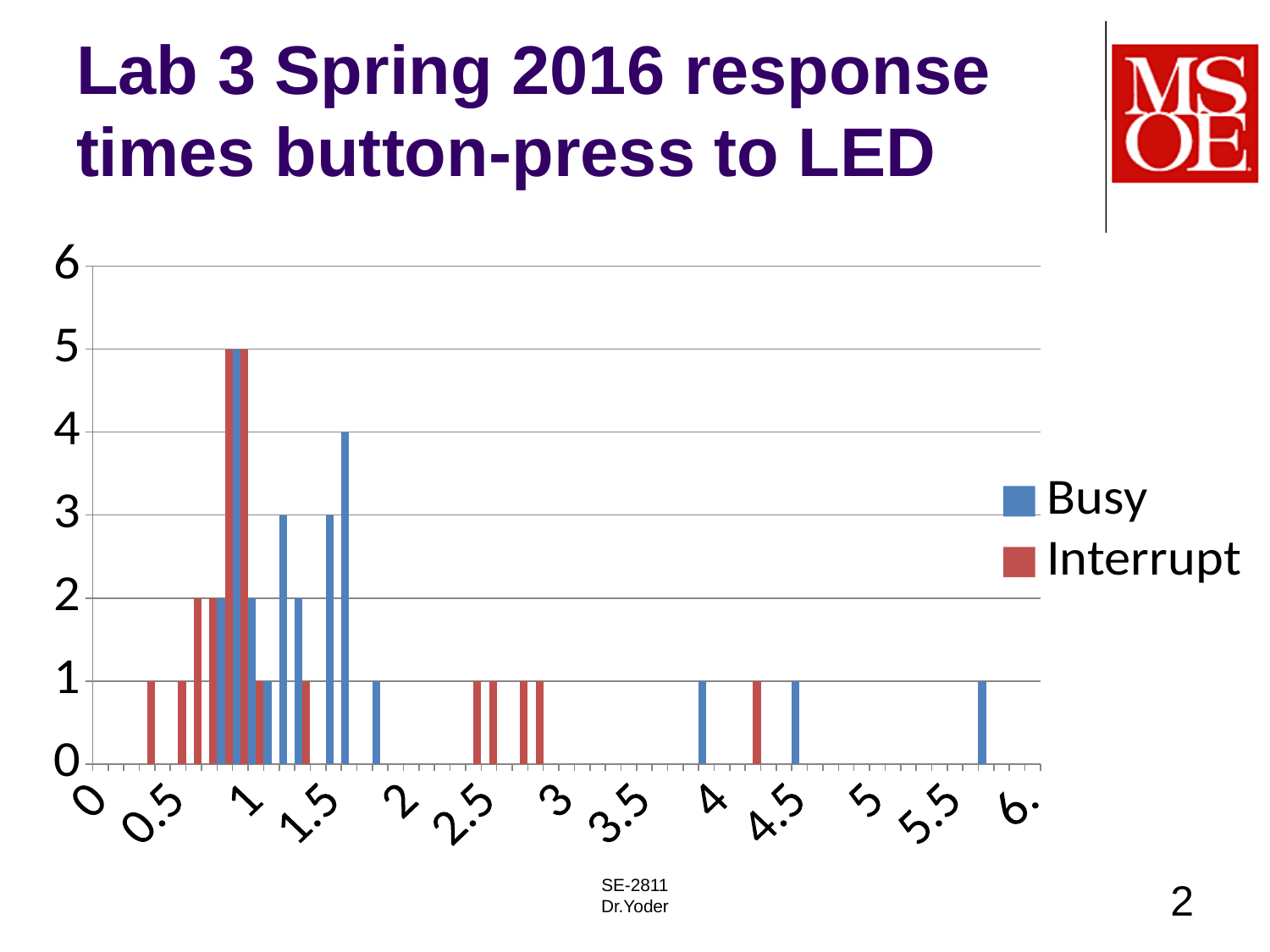
Is the Busy bar located just before 4 on the x axis greater or less than 2? less How many labelled tick values are shown on the x axis? 13 Are there any bars between 3 and 4 on the x axis? Yes How many series does the legend list? 2 Is the tallest bar in the chart greater or less than 4? greater Which series has a bar located beyond 5.5 on the x axis? Busy What kind of chart is shown on the slide? bar chart What is the height of the tallest Busy bar located between 1.5 and 2 on the x axis? 4 What are the two series named in the legend? Busy and Interrupt What is the highest value reached by any bar in the chart? 5 What colour represents the Interrupt series? red